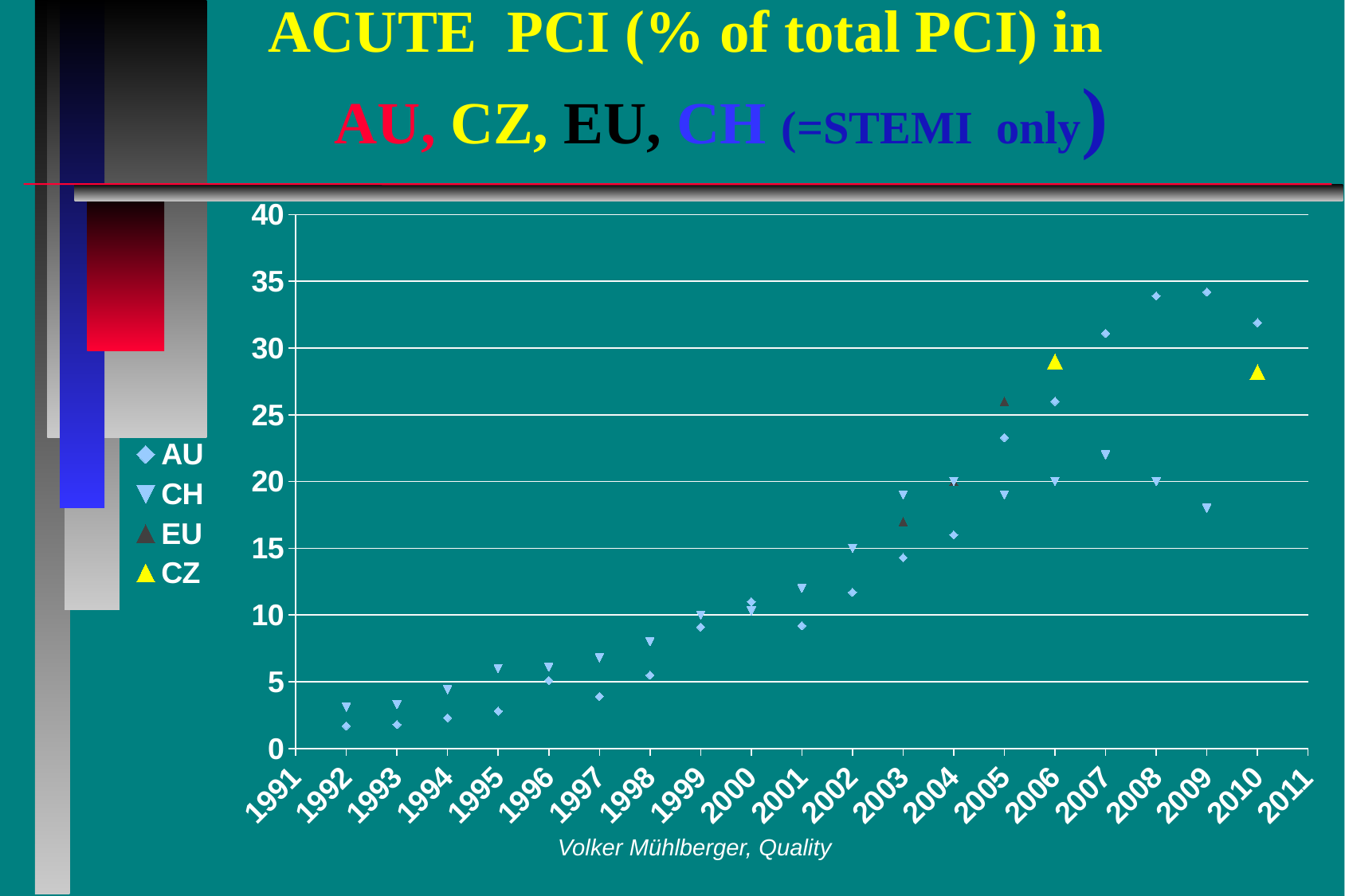
Is the CH value for 2009 greater or less than 20? less Which is larger in 2009, the AU value or the CH value? AU Which series are listed in the legend? AU, CH, EU, CZ Is the CZ value for 2006 greater or less than 25? greater How many CZ data points are plotted on the chart? 2 Do the AU values generally rise or fall from 1992 to 2009? rise Which is larger in 2006, the CZ value or the AU value? CZ Is the EU value for 2003 greater or less than 20? less How many series does the legend list? 4 What kind of chart is shown on the slide? scatter chart